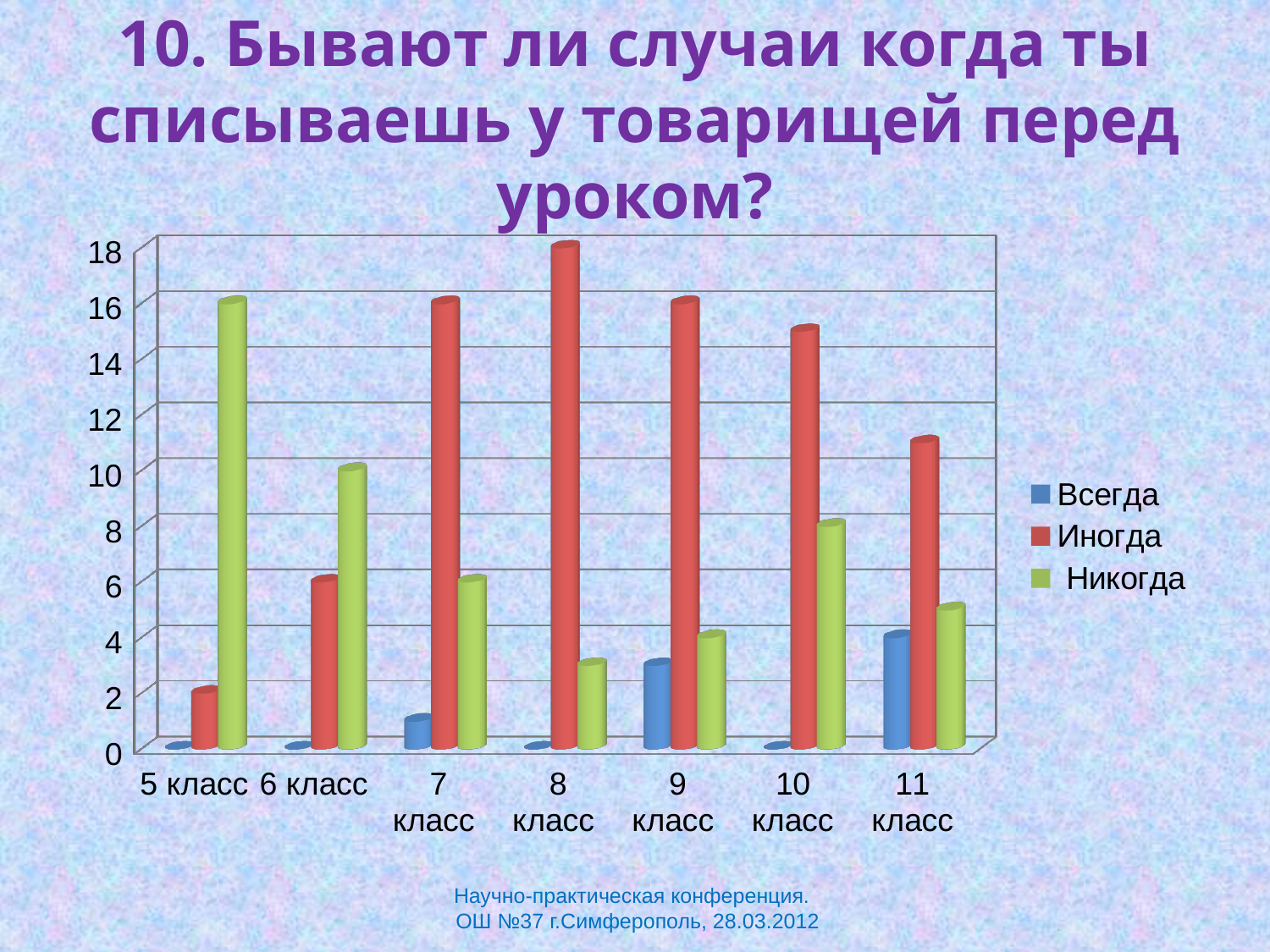
Which class has the highest value for Иногда? 8 класс Is the value for Никогда in 8 класс greater or less than 4? less How many classes (categories) are shown on the x axis? 7 What kind of chart is shown on the slide? bar chart Which class has the highest value for Всегда? 11 класс Is the value for Иногда in 10 класс greater or less than 14? greater Which legend entry is shown in red? Иногда Which is larger in 11 класс: Иногда or Никогда? Иногда Which class has the highest value for Никогда? 5 класс Is the value for Иногда in 8 класс greater or less than 16? greater How many series does the legend list? 3 Which is larger in 6 класс: Иногда or Никогда? Никогда